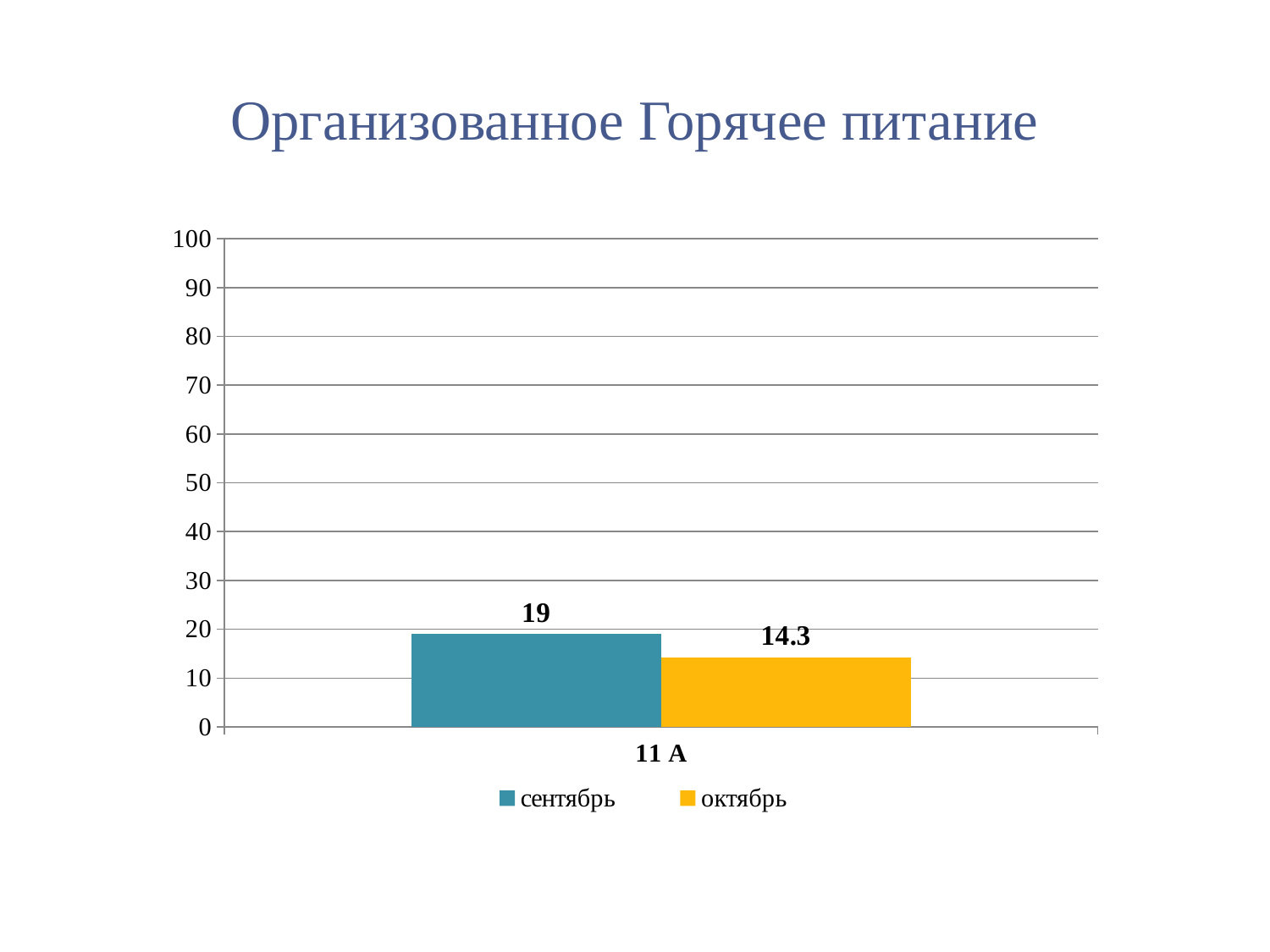
What is the difference between the сентябрь and октябрь values for 11 А? 4.7 How many categories are shown on the x axis? 1 Is the value for октябрь for 11 А greater or less than 10? greater What is the maximum value shown on the y axis? 100 What kind of chart is shown on the slide? bar chart Which series has the higher value for 11 А, сентябрь or октябрь? сентябрь What is the value for сентябрь for 11 А? 19 How many series does the legend list? 2 Is the value for сентябрь for 11 А greater or less than 30? less What is the value for октябрь for 11 А? 14.3 What is the title of the slide? Организованное Горячее питание Which series is shown in yellow? октябрь